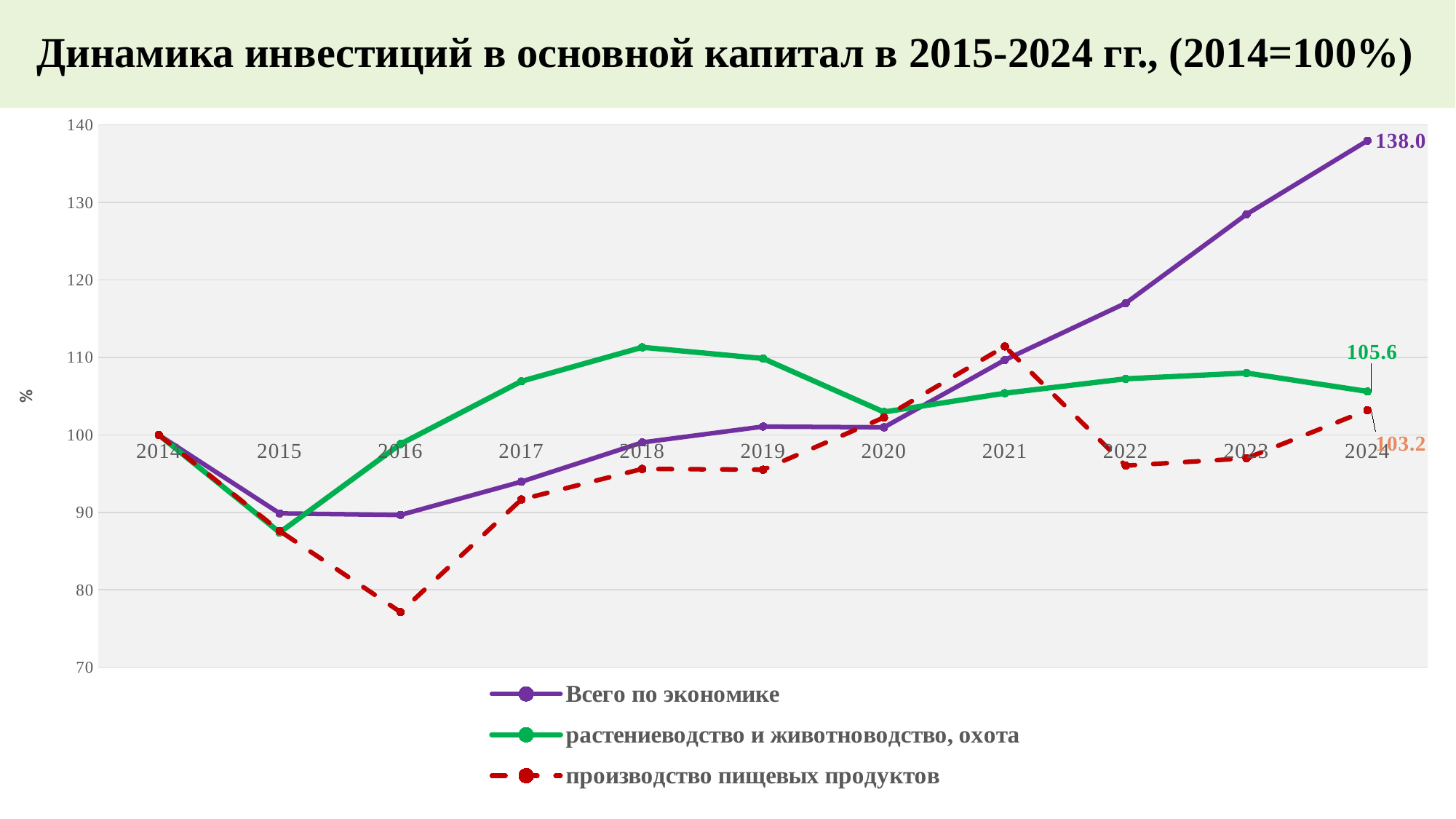
How many series does the legend list? 3 What is the value for "растениеводство и животноводство, охота" in 2024? 105.6 Which series has the highest value in 2024? Всего по экономике Is the value for "производство пищевых продуктов" in 2016 greater or less than 80? less What is the value for "Всего по экономике" in 2024? 138.0 Is the value for "растениеводство и животноводство, охота" in 2018 greater or less than 110? greater Which series has the lowest value in 2024? производство пищевых продуктов What is the value for "производство пищевых продуктов" in 2024? 103.2 Does the "Всего по экономике" line rise or fall from 2020 to 2024? rise How many years are shown on the x axis? 11 What is the difference between the 2024 values of "Всего по экономике" and "растениеводство и животноводство, охота"? 32.4 What type of chart is shown on the slide? line chart